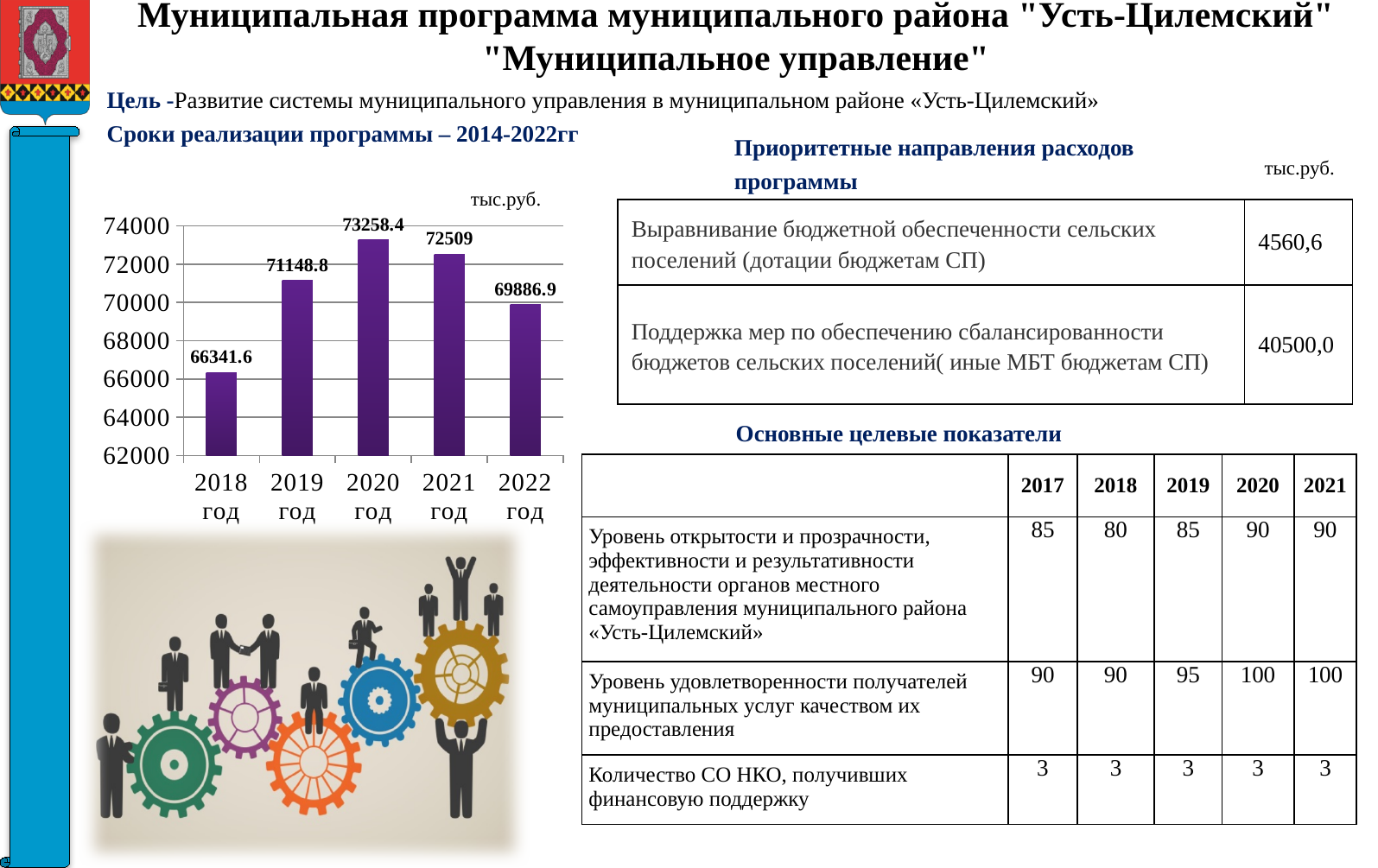
What is the value for 2022 год in the bar chart? 69886.9 What is the difference between the values for 2019 год and 2018 год in the bar chart? 4807.2 What is the difference between the values for 2020 год and 2021 год in the bar chart? 749.4 What is the value for 2018 год in the bar chart? 66341.6 What is the value for 2020 год in the bar chart? 73258.4 Is the value for 2021 год in the bar chart greater or less than 72000? greater What kind of chart is shown on the slide? bar chart What unit is indicated above the bar chart? тыс.руб. Which year has the lowest value in the bar chart? 2018 год Which is larger in the bar chart, the value for 2019 год or the value for 2022 год? 2019 год Which year has the highest value in the bar chart? 2020 год How many years are shown in the bar chart? 5